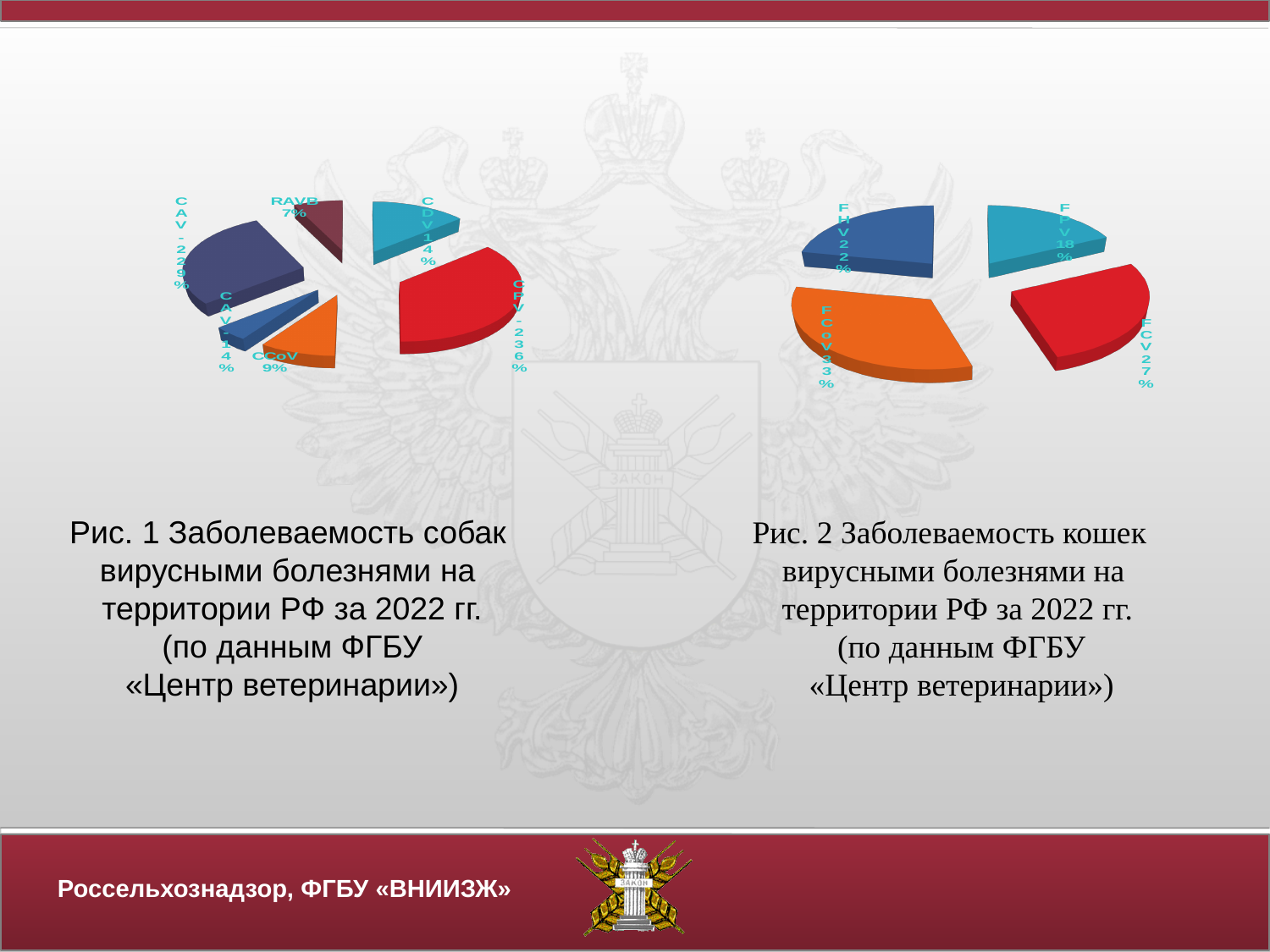
In Рис. 2 (right chart, cats), what is the difference between FCV and FHV? 5% In Рис. 2 (right chart, cats), which category has the largest share? FCoV In Рис. 1 (left chart, dogs), which is larger, CAV-2 or CDV? CAV-2 In Рис. 1 (left chart, dogs), what is the value for CPV-2? 36% What kind of chart is shown in Рис. 1 (left chart)? Pie chart In Рис. 1 (left chart, dogs), what is the difference between CDV and RAVB? 7% In Рис. 2 (right chart, cats), how many slices does the pie have? 4 In Рис. 1 (left chart, dogs), what share does CCoV have? 9% In Рис. 1 (left chart, dogs), which category has the largest share? CPV-2 In Рис. 2 (right chart, cats), which category has the smallest share? FPV In Рис. 2 (right chart, cats), what is the value for FPV? 18% In Рис. 2 (right chart, cats), what share does FCoV have? 33%